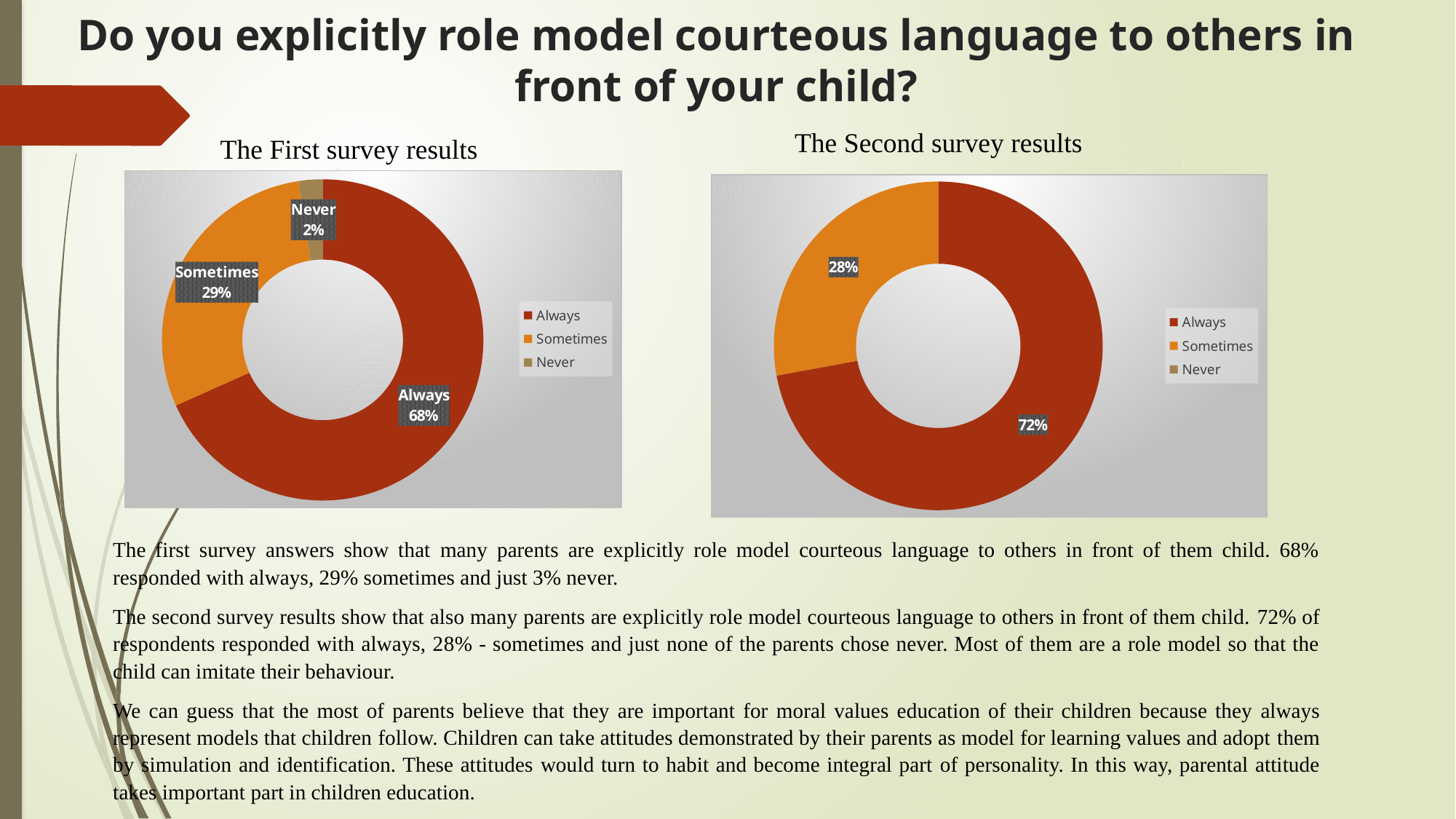
In the First survey results chart, what is the difference in percentage points between Always and Sometimes? 39 In the First survey results chart, what percentage of respondents answered Sometimes? 29% How many categories are labelled in the First survey results chart? 3 In the Second survey results chart, what is the difference in percentage points between the Always and Sometimes slices? 44 In the First survey results chart, which response has the smallest share? Never In the First survey results chart, which response has the largest share? Always In the First survey results chart, what percentage of respondents answered Always? 68% What type of chart is used for the Second survey results? Doughnut (pie) chart Is the Always share larger in the First survey results chart or the Second survey results chart? The Second survey results In the Second survey results chart, what percentage is shown for the Always slice? 72% In the First survey results chart, what percentage of respondents answered Never? 2% In the Second survey results chart, what percentage is shown for the Sometimes slice? 28%